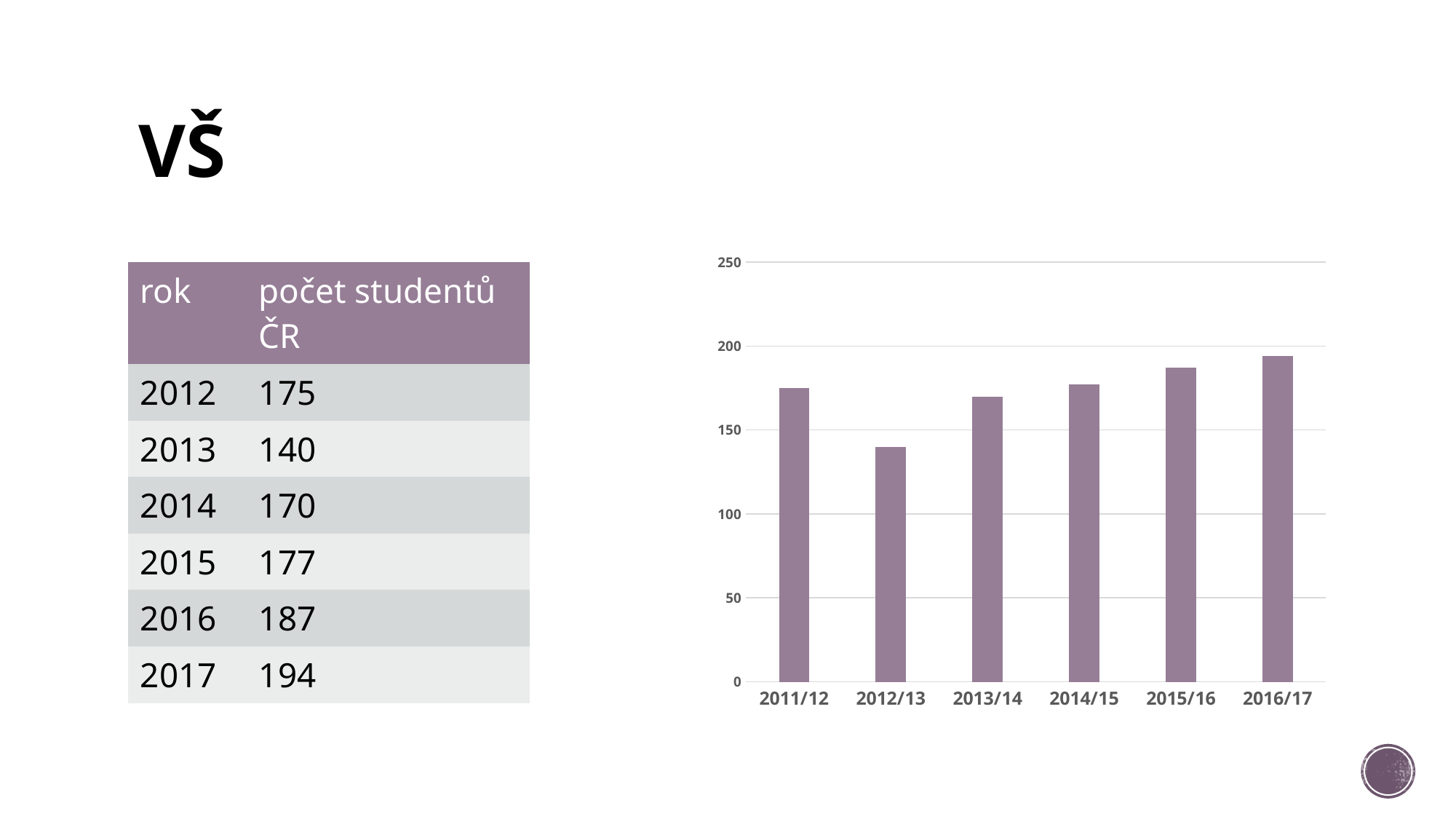
Which academic year has the lowest bar in the chart? 2012/13 Is the value for 2011/12 greater or less than 150? greater Which academic year has the highest bar in the chart? 2016/17 How many categories (academic years) are shown on the x axis of the chart? 6 Is the value for 2012/13 greater or less than 150? less What is the title of the slide containing the chart? VŠ Do the values rise or fall from 2012/13 to 2016/17? rise Is the value for 2016/17 greater or less than 200? less What is the highest value shown on the chart's vertical axis? 250 Which is larger, the value for 2011/12 or the value for 2012/13? 2011/12 What kind of chart is shown on the slide? bar chart